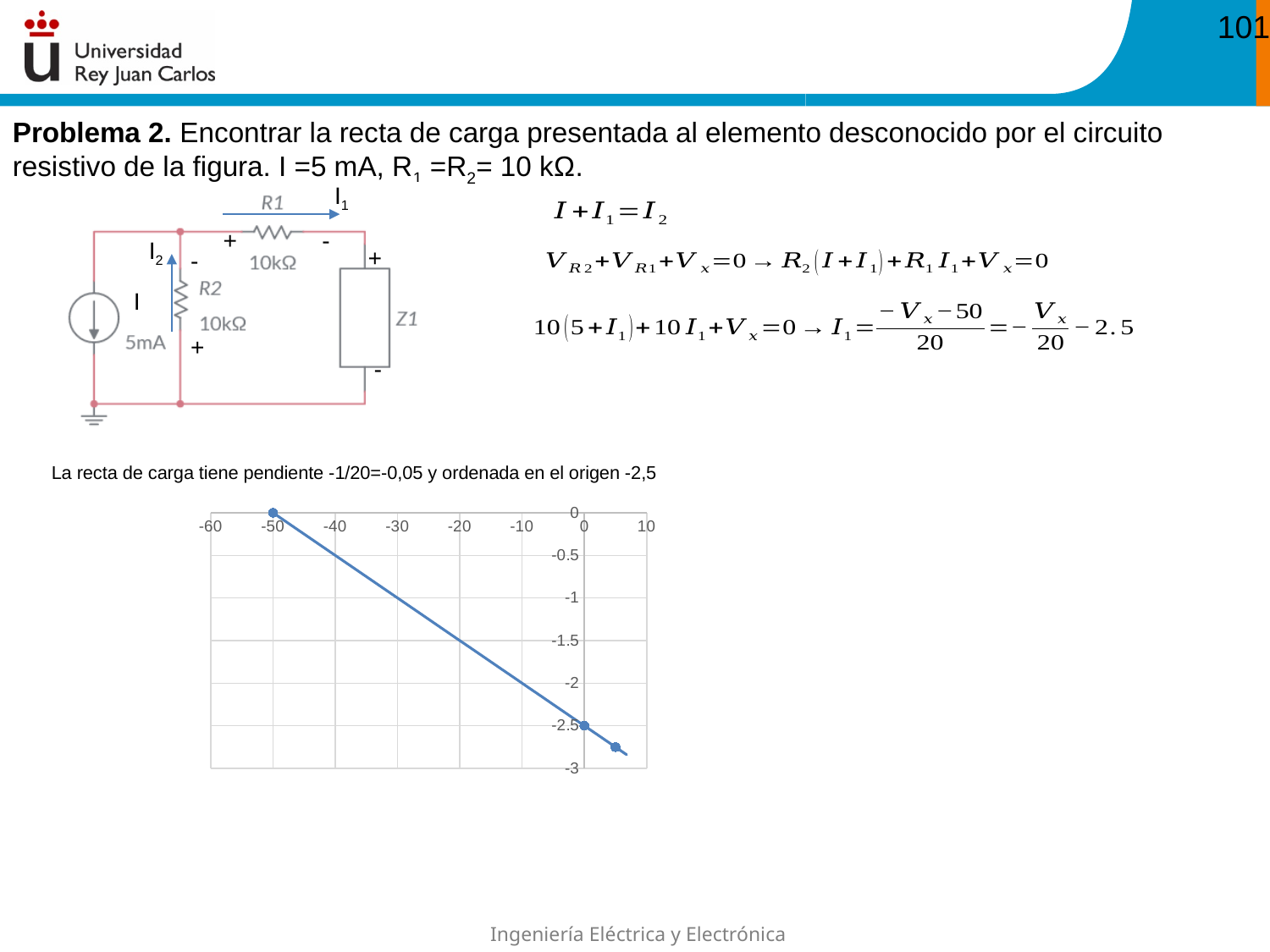
Do the plotted values rise or fall as the x axis increases? fall What is the difference between the y values of the points at x = -50 and x = 0? 2.5 What is the y value of the plotted point at x = 0? -2.5 Which plotted point has the highest y value, the one at x = -50 or the one at x = 0? the one at x = -50 What is the y value of the plotted point at x = -50? 0 Is the y value of the rightmost plotted point greater or less than -2.5? less What kind of chart is shown on the slide? line chart What is the lowest value labelled on the y axis? -3 What is the lowest value labelled on the x axis? -60 Is the y value of the line at x = -20 greater or less than -1? less Is the y value of the line at x = -40 greater or less than -1? greater How many data point markers are plotted on the line? 3